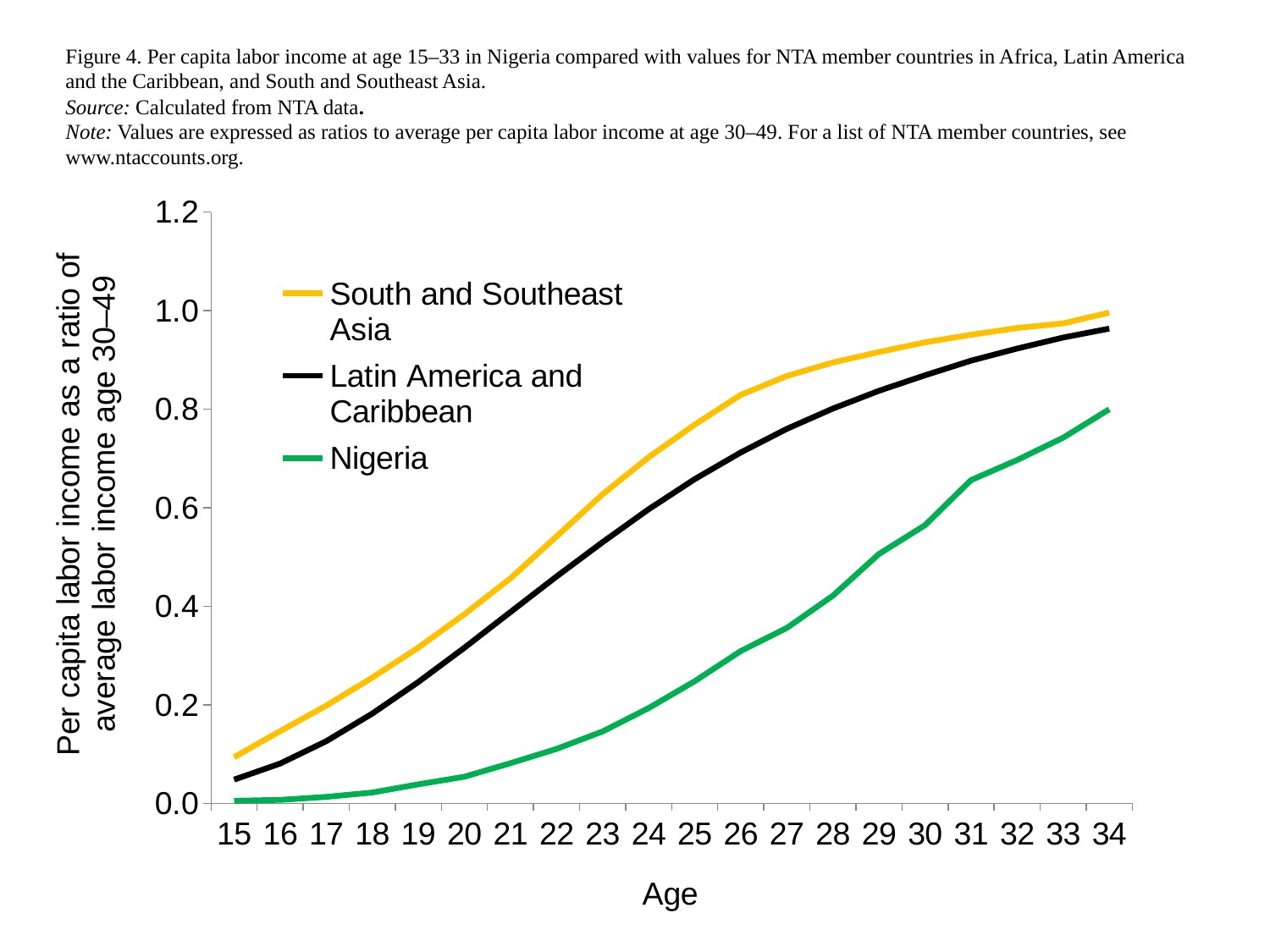
How many series does the legend list? 3 What kind of chart is shown on the slide? line chart How many age values are shown along the x axis? 20 Is the value for Nigeria at age 20 greater or less than 0.2? less Which series has the highest value at age 30? South and Southeast Asia What is the label of the x axis? Age Is the value for South and Southeast Asia at age 26 greater or less than 0.8? greater Which series has the lowest value at age 20? Nigeria At age 25, which is larger: the value for South and Southeast Asia or the value for Nigeria? South and Southeast Asia Is the value for Latin America and Caribbean at age 30 greater or less than 0.8? greater Do the values for Nigeria rise or fall as age increases from 15 to 34? rise